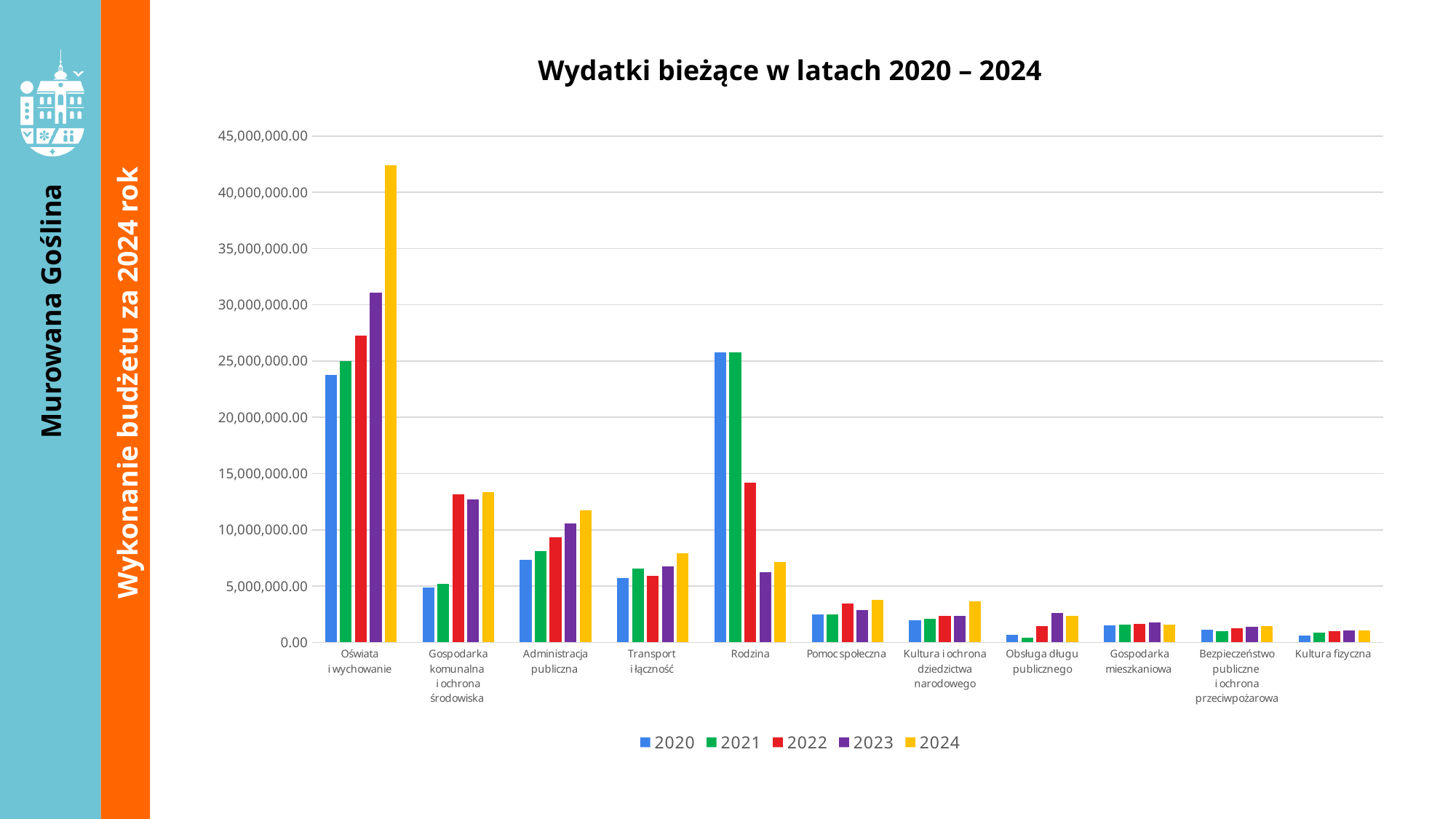
Is the 2024 value for Administracja publiczna greater or less than 10,000,000.00? greater What type of chart is shown on the slide? bar chart How many categories are shown on the x axis? 11 Which category has the highest value for 2024? Oświata i wychowanie How many series does the legend list? 5 Is the 2024 value for Oświata i wychowanie greater or less than 40,000,000.00? greater Which category has the lowest value for 2021? Obsługa długu publicznego What is the title of the chart? Wydatki bieżące w latach 2020 – 2024 Is the 2022 value for Rodzina greater or less than 15,000,000.00? less Which colour represents the 2024 series in the legend? yellow Which is larger for 2020: Rodzina or Oświata i wychowanie? Rodzina Do the values for Oświata i wychowanie rise or fall from 2020 to 2024? rise